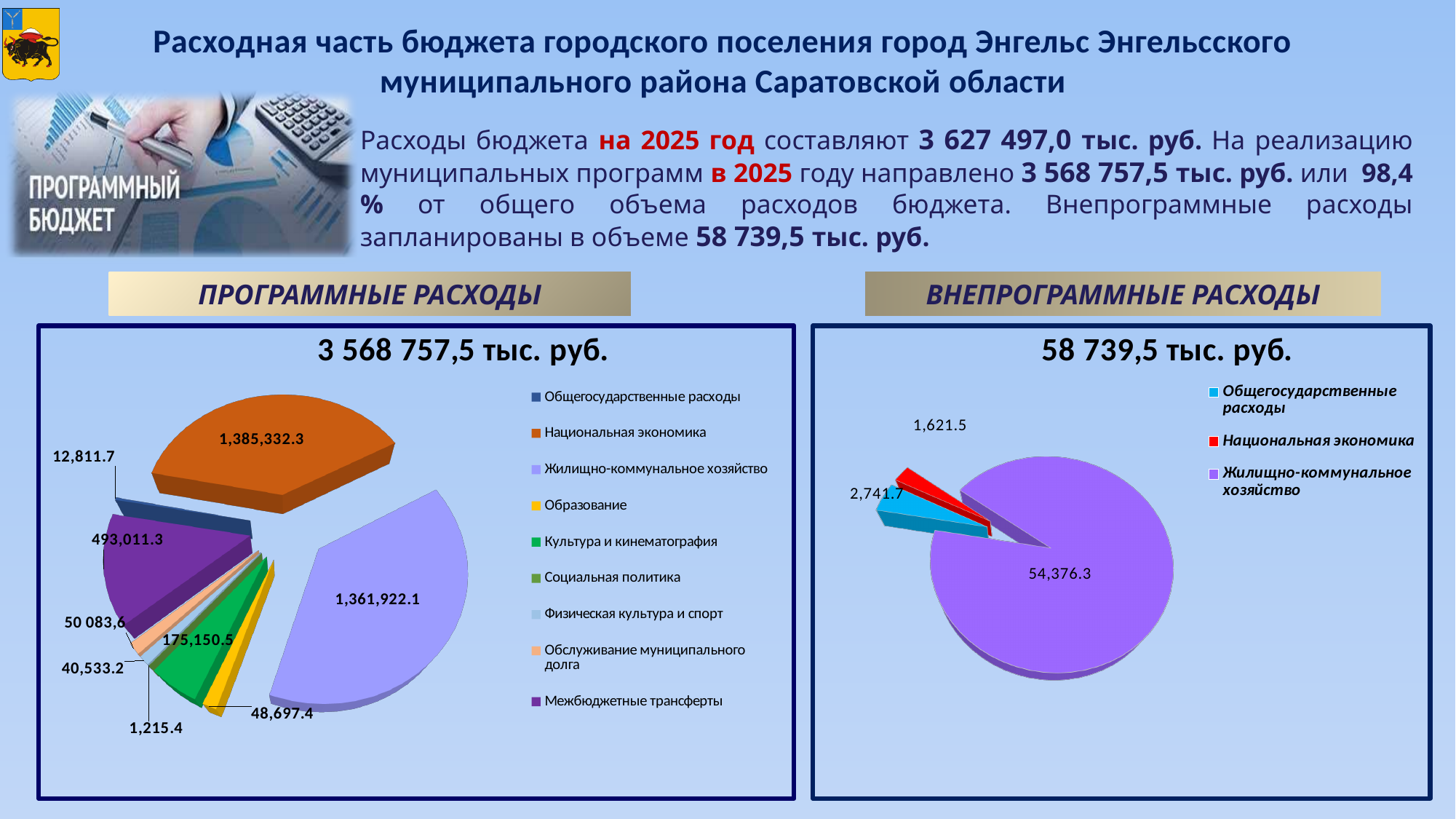
In the right chart (ВНЕПРОГРАММНЫЕ РАСХОДЫ), which is larger: Общегосударственные расходы or Национальная экономика? Общегосударственные расходы In the left chart (ПРОГРАММНЫЕ РАСХОДЫ), what is the value for Национальная экономика? 1,385,332.3 In the right chart (ВНЕПРОГРАММНЫЕ РАСХОДЫ), what is the value for Жилищно-коммунальное хозяйство? 54,376.3 In the left chart (ПРОГРАММНЫЕ РАСХОДЫ), what is the difference between Национальная экономика and Жилищно-коммунальное хозяйство? 23,410.2 In the right chart (ВНЕПРОГРАММНЫЕ РАСХОДЫ), what is the value for Национальная экономика? 1,621.5 In the right chart (ВНЕПРОГРАММНЫЕ РАСХОДЫ), which category has the smallest value? Национальная экономика What kind of chart is shown under ПРОГРАММНЫЕ РАСХОДЫ on the left? Pie chart In the left chart (ПРОГРАММНЫЕ РАСХОДЫ), what is the value for Межбюджетные трансферты? 493,011.3 In the left chart (ПРОГРАММНЫЕ РАСХОДЫ), which category has the largest value? Национальная экономика How many categories does the legend of the left chart (ПРОГРАММНЫЕ РАСХОДЫ) list? 9 In the left chart (ПРОГРАММНЫЕ РАСХОДЫ), what is the value for Общегосударственные расходы? 12,811.7 In the left chart (ПРОГРАММНЫЕ РАСХОДЫ), what is the value for Жилищно-коммунальное хозяйство? 1,361,922.1